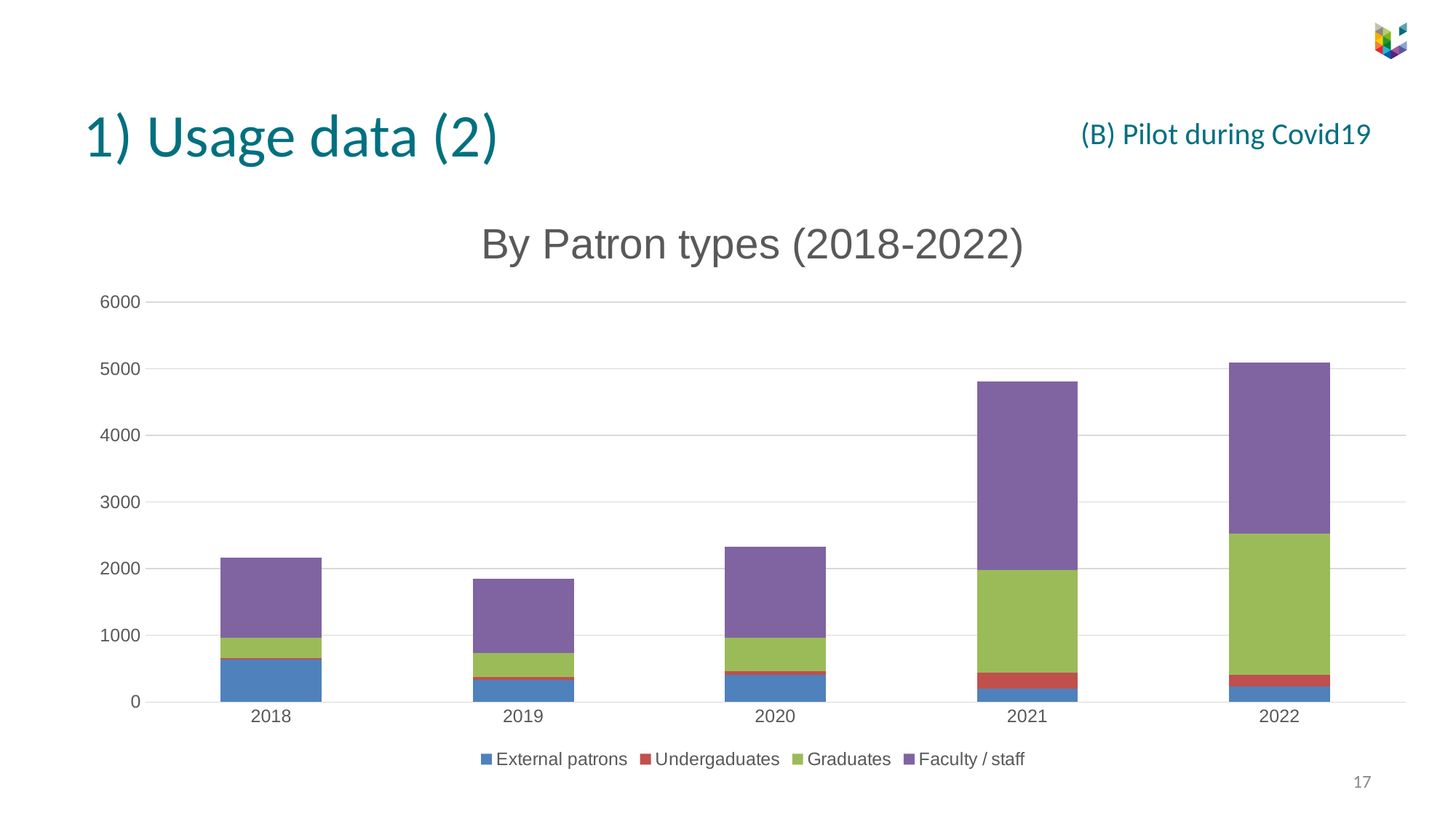
Is the total bar for 2021 greater or less than 5000? less Is the total bar for 2018 greater or less than 2000? greater What is the title of the chart? By Patron types (2018-2022) Which year has the larger total bar, 2020 or 2021? 2021 Which colour represents Faculty / staff in the chart's legend? Purple What kind of chart is shown on the slide? Stacked bar chart Is the total bar for 2019 greater or less than 2000? less How many series does the chart's legend list? 4 How many years are shown on the x axis of the chart? 5 Which year has the lowest total bar in the chart? 2019 Which year has the highest total bar in the chart? 2022 Which year has the larger total bar, 2018 or 2019? 2018